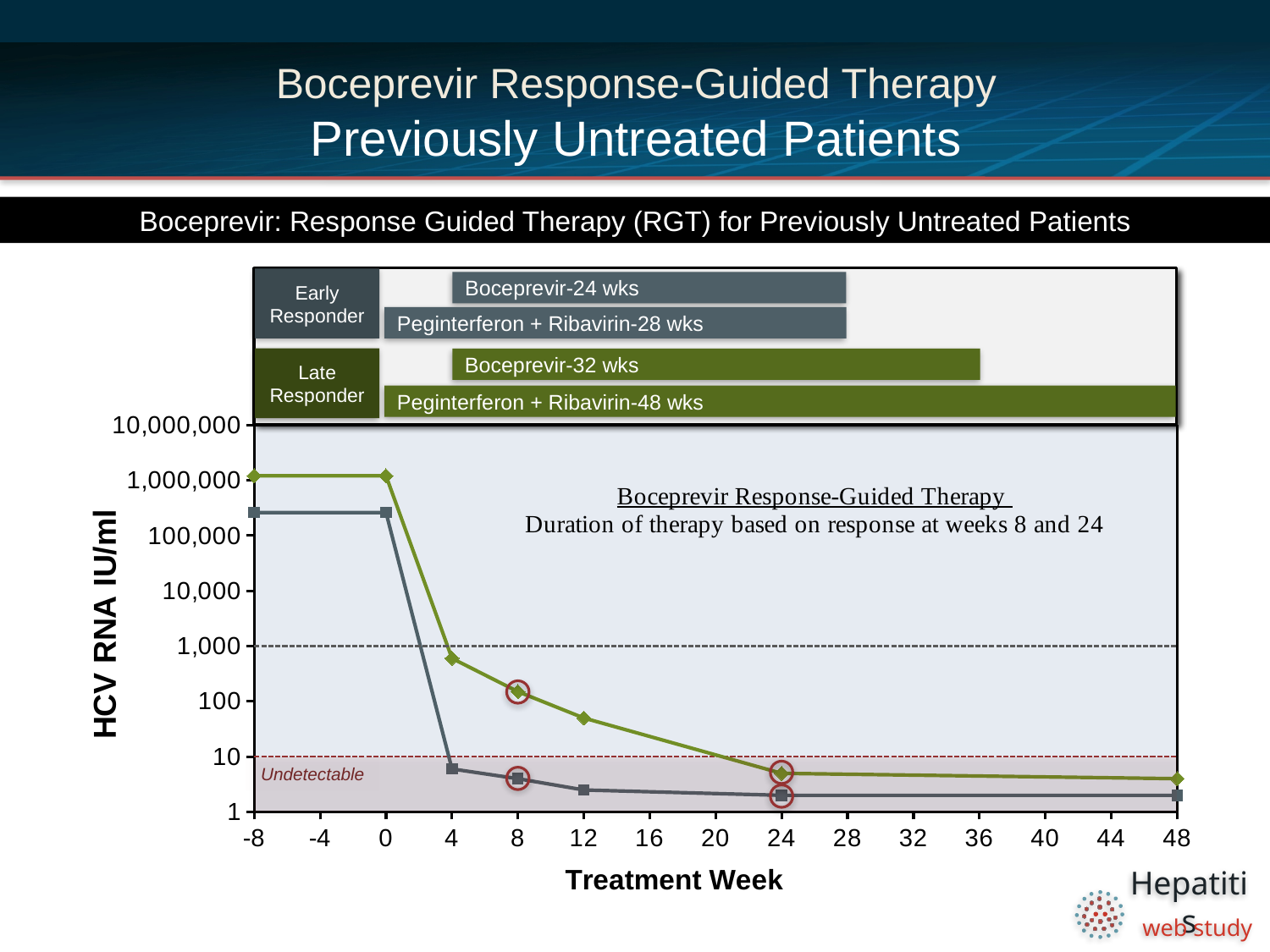
Is the Late Responder (green) value at treatment week 24 greater or less than 10? less What kind of chart is shown on the slide? line chart Is the Late Responder (green) value at treatment week 4 greater or less than 100? greater At treatment week 8, which line has the higher HCV RNA value, the Early Responder (gray) or the Late Responder (green)? Late Responder (green) Is the Early Responder (gray) value at treatment week 4 greater or less than 10? less What is the title of the x-axis of the chart? Treatment Week How many tick labels are shown on the x-axis (Treatment Week)? 15 Do the HCV RNA values rise or fall as treatment week increases from 0 to 48? fall What is the title of the y-axis of the chart? HCV RNA IU/ml